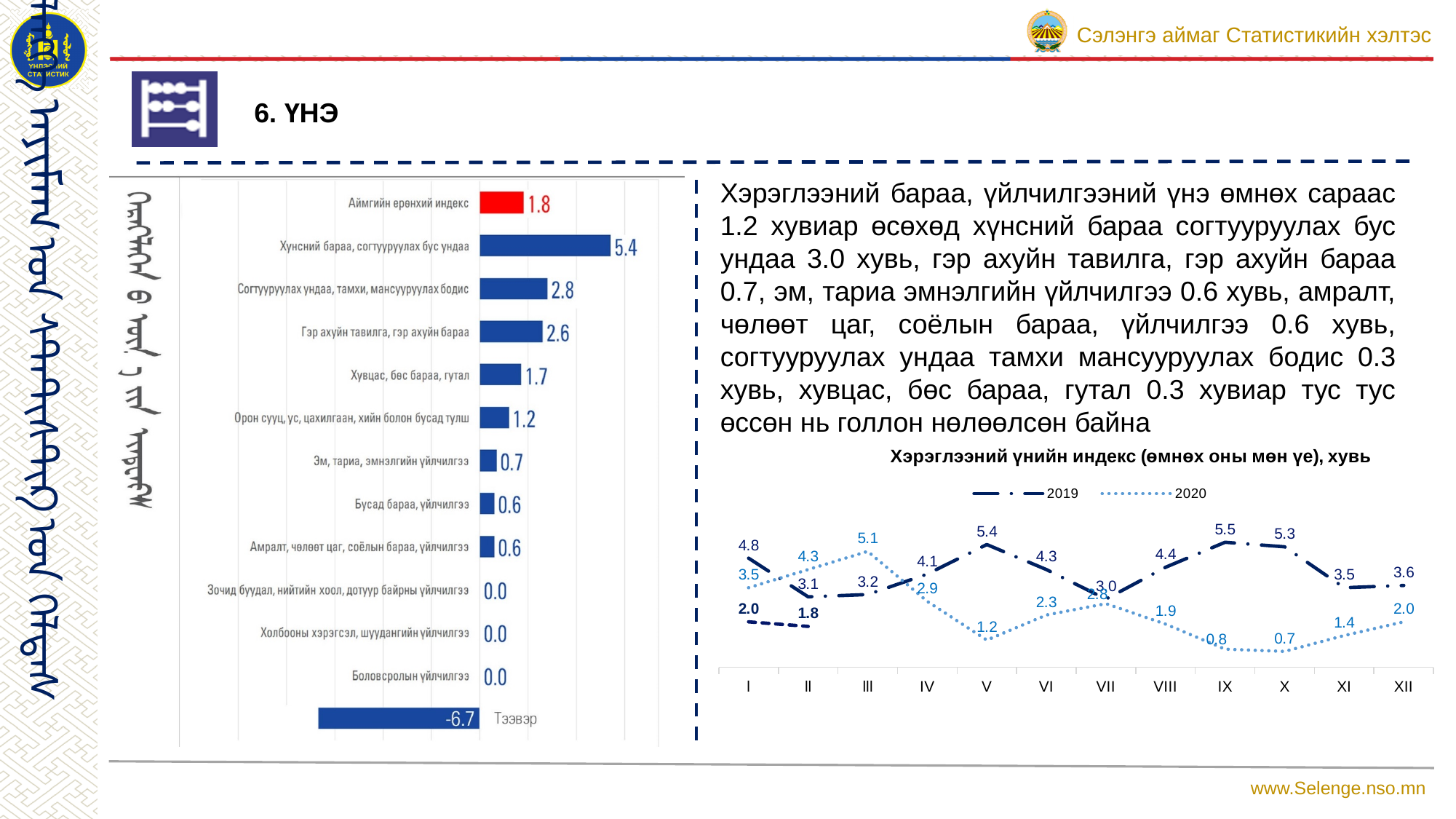
In the chart titled 'Хэрэглээний үнийн индекс (өмнөх оны мөн үе), хувь', which is larger in month III: the 2019 value or the 2020 value? 2020 In the bar chart on the left, what is the value for Хүнсний бараа, согтууруулах бус ундаа? 5.4 In the bar chart on the left, what is the difference between the values for Согтууруулах ундаа, тамхи, мансууруулах бодис and Гэр ахуйн тавилга, гэр ахуйн бараа? 0.2 In the chart titled 'Хэрэглээний үнийн индекс (өмнөх оны мөн үе), хувь', how many series does the legend list? 2 In the bar chart on the left, which category has the lowest value? Тээвэр In the bar chart on the left, what kind of chart is shown? Bar chart In the chart titled 'Хэрэглээний үнийн индекс (өмнөх оны мөн үе), хувь', what is the difference between the 2019 and 2020 values in month V? 4.2 In the chart titled 'Хэрэглээний үнийн индекс (өмнөх оны мөн үе), хувь', what is the value for 2020 in month X? 0.7 In the bar chart on the left, what is the value for Аймгийн ерөнхий индекс? 1.8 In the bar chart on the left, which category has the highest value? Хүнсний бараа, согтууруулах бус ундаа In the chart titled 'Хэрэглээний үнийн индекс (өмнөх оны мөн үе), хувь', what is the value for 2019 in month IX? 5.5 In the bar chart on the left, what is the value for Тээвэр? -6.7